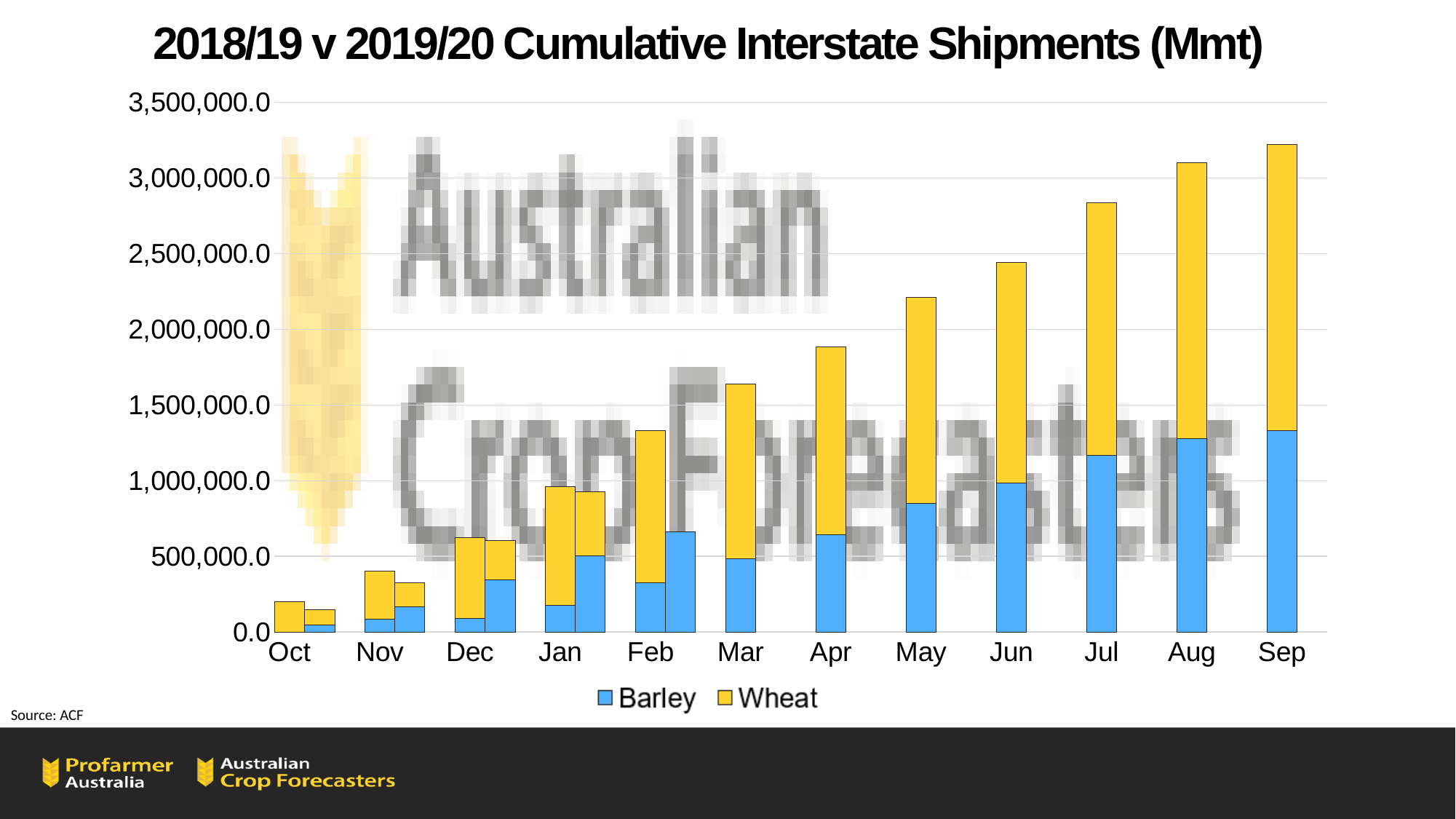
Is the total stacked value for May greater or less than 2,000,000.0? greater What is the title of the chart? 2018/19 v 2019/20 Cumulative Interstate Shipments (Mmt) Is the total stacked value for Apr greater or less than 2,000,000.0? less Which series is shown in blue? Barley Is the Barley value for May greater or less than 1,000,000.0? less How many months are shown on the x axis? 12 How many series does the legend list? 2 Which month has the highest total stacked bar? Sep What kind of chart is shown on the slide? Stacked bar chart